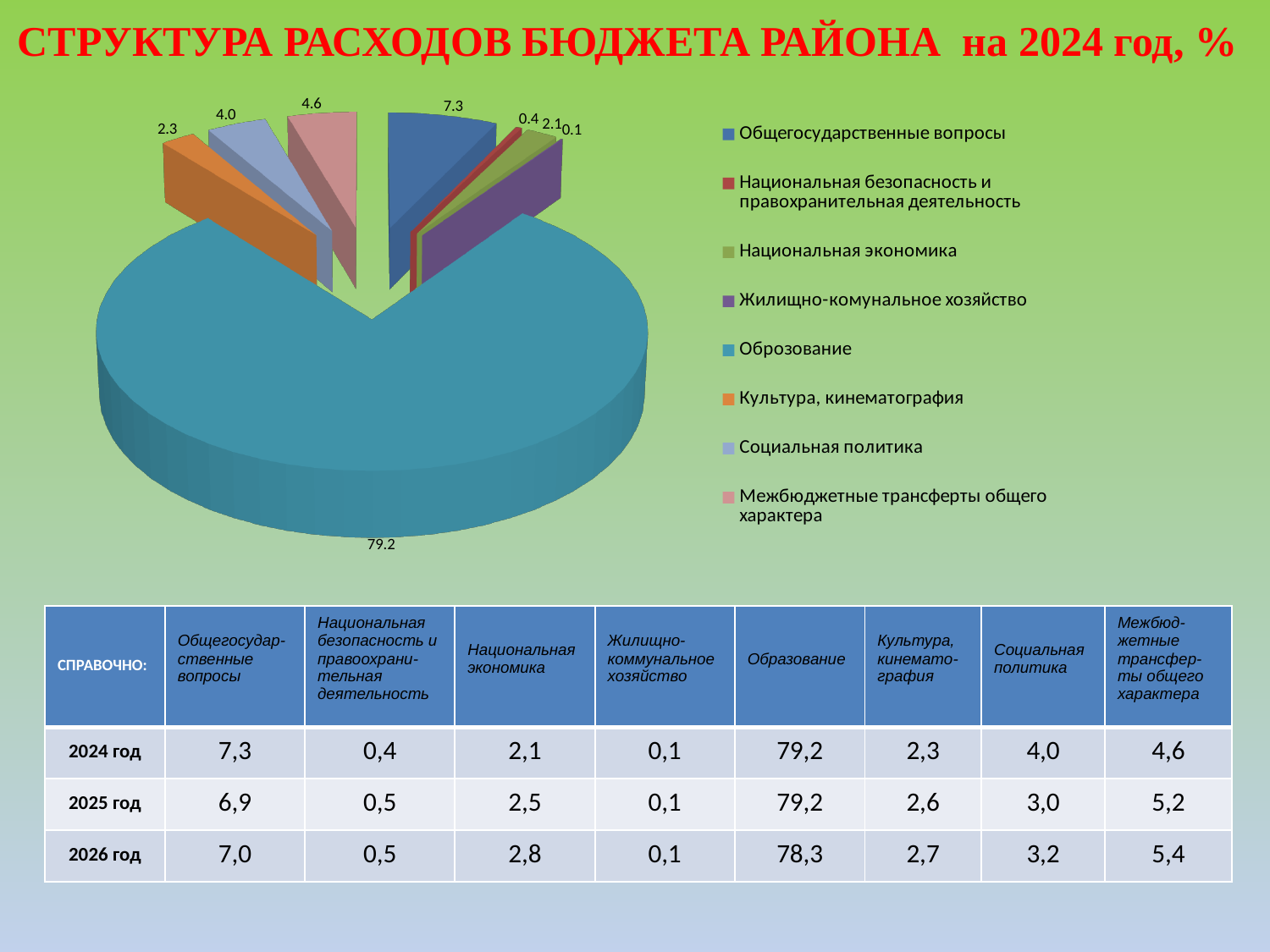
What is the value for Социальная политика in the pie chart? 4.0 What is the value for Жилищно-коммунальное хозяйство in the pie chart? 0.1 What kind of chart is shown on the slide? pie chart What is the value for Межбюджетные трансферты общего характера in the pie chart? 4.6 What is the title of the chart on the slide? СТРУКТУРА РАСХОДОВ БЮДЖЕТА РАЙОНА на 2024 год, % How many categories does the legend of the pie chart list? 8 What is the difference between the values for Общегосударственные вопросы and Культура, кинематография in the pie chart? 5.0 What is the value for Общегосударственные вопросы in the pie chart? 7.3 Which category has the largest slice in the pie chart? Образование Which is larger in the pie chart: Социальная политика or Национальная экономика? Социальная политика What is the value for Образование in the pie chart? 79.2 Which category has the smallest slice in the pie chart? Жилищно-коммунальное хозяйство